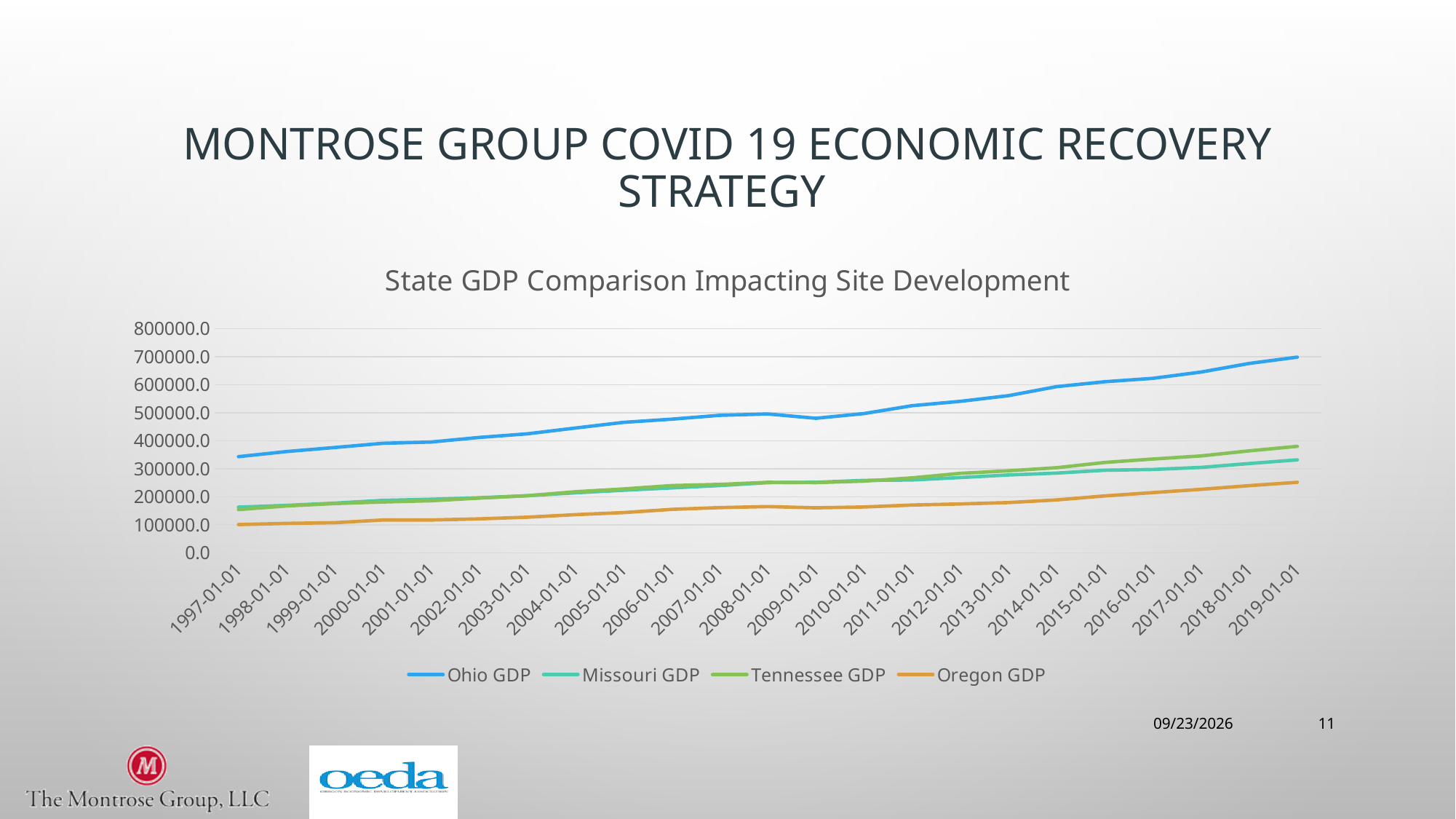
At 2019-01-01, which is larger: Tennessee GDP or Missouri GDP? Tennessee GDP Which state's GDP line is highest across the chart? Ohio GDP Does Ohio GDP generally rise or fall from 1997-01-01 to 2019-01-01? rise At 2010-01-01, which is larger: Ohio GDP or Oregon GDP? Ohio GDP Is the value for Ohio GDP at 1997-01-01 greater or less than 300000.0? greater How many dates are shown along the x axis? 23 What is the title of the chart? State GDP Comparison Impacting Site Development Is the value for Oregon GDP at 2019-01-01 greater or less than 200000.0? greater Is the value for Oregon GDP at 1997-01-01 greater or less than 200000.0? less How many series does the legend list? 4 What kind of chart is shown on the slide? line chart Which state's GDP line is lowest across the chart? Oregon GDP